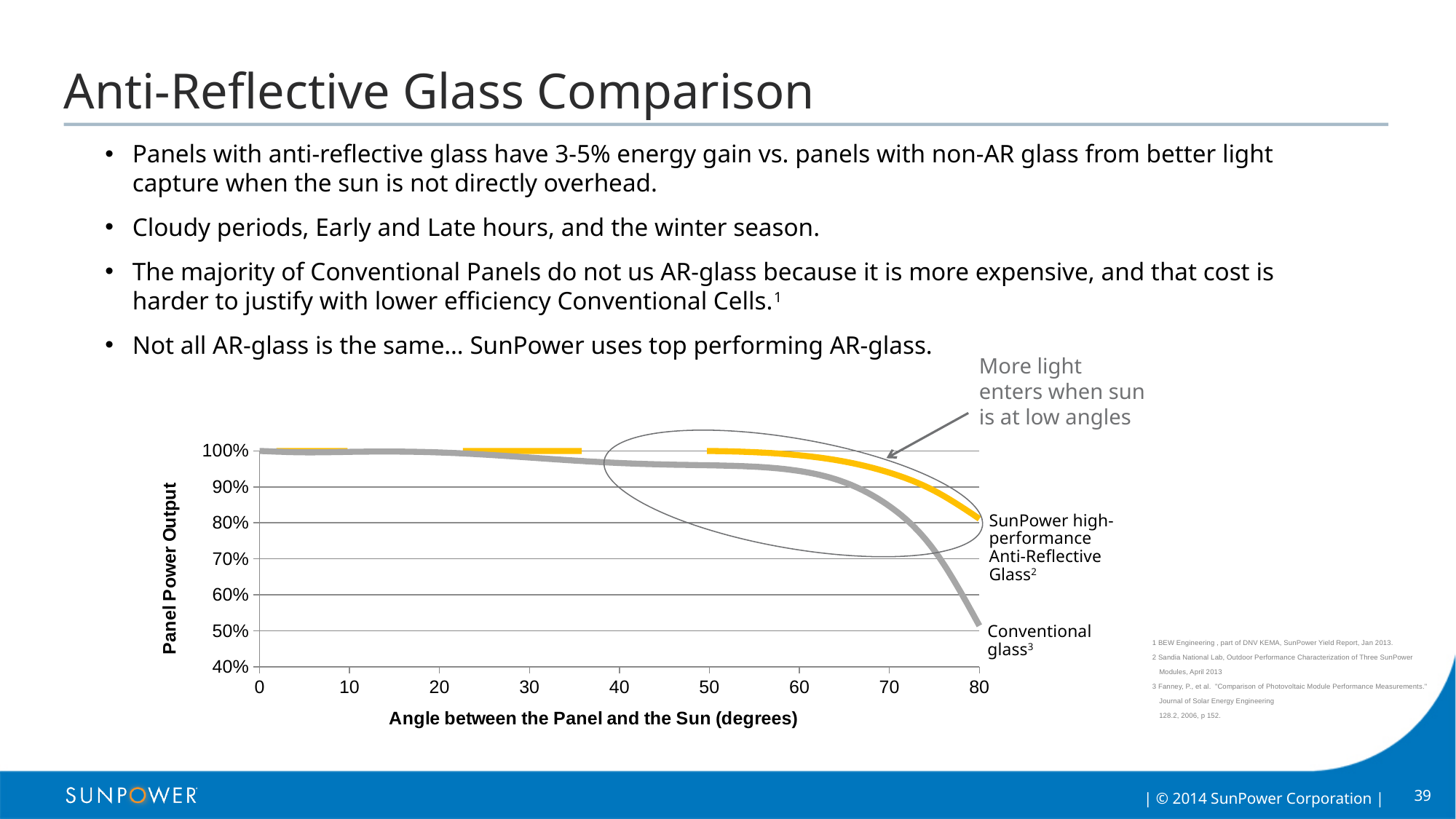
What kind of chart is shown on the slide? Line chart What is the highest value shown on the chart's x axis? 80 Is the panel power output for Conventional glass at 60 degrees greater or less than 90%? greater At 80 degrees, which series has the higher panel power output: SunPower high-performance Anti-Reflective Glass or Conventional glass? SunPower high-performance Anti-Reflective Glass Is the panel power output for Conventional glass at 40 degrees greater or less than 90%? greater How many tick labels are shown on the chart's x axis? 9 Does panel power output rise or fall as the angle between the panel and the sun increases? Fall What is the title of the chart's y axis? Panel Power Output How many data series are plotted on the chart? 2 What is the title of the chart's x axis? Angle between the Panel and the Sun (degrees) Is the panel power output for SunPower high-performance Anti-Reflective Glass at 80 degrees greater or less than 70%? greater